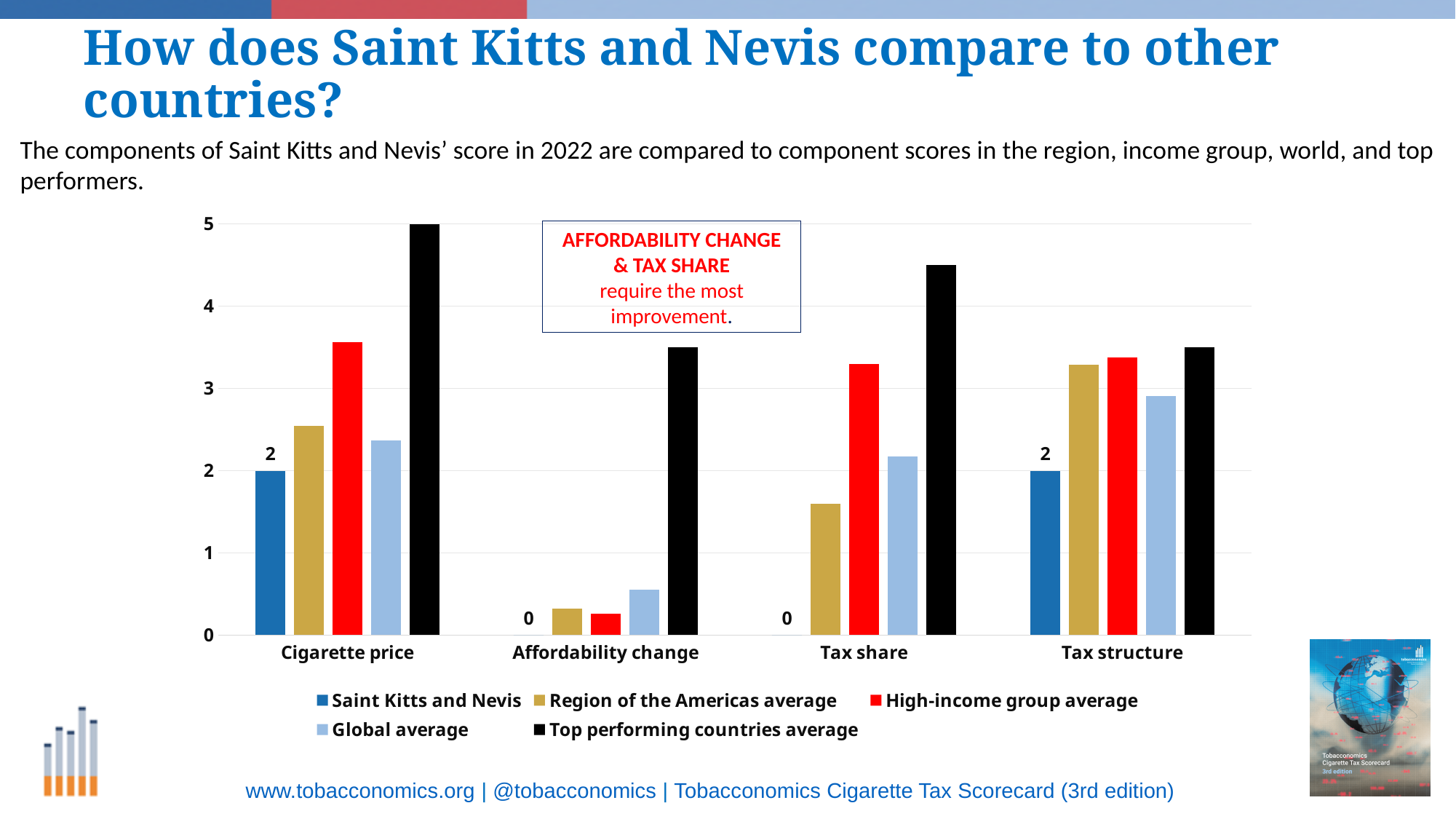
Which series has the highest value in the Cigarette price category? Top performing countries average What is the value for Saint Kitts and Nevis in the Tax share category? 0 How many series does the chart's legend list? 5 Is the value for Region of the Americas average in the Tax share category greater or less than 2? less What is the value for Top performing countries average in the Cigarette price category? 5 How many categories are shown on the x axis of the chart? 4 What is the value for Saint Kitts and Nevis in the Affordability change category? 0 What is the value for Saint Kitts and Nevis in the Tax structure category? 2 What kind of chart is shown on the slide? Bar chart According to the text box on the chart, which components require the most improvement? Affordability change & Tax share In the Tax share category, which is larger: Region of the Americas average or High-income group average? High-income group average What is the value for Saint Kitts and Nevis in the Cigarette price category? 2